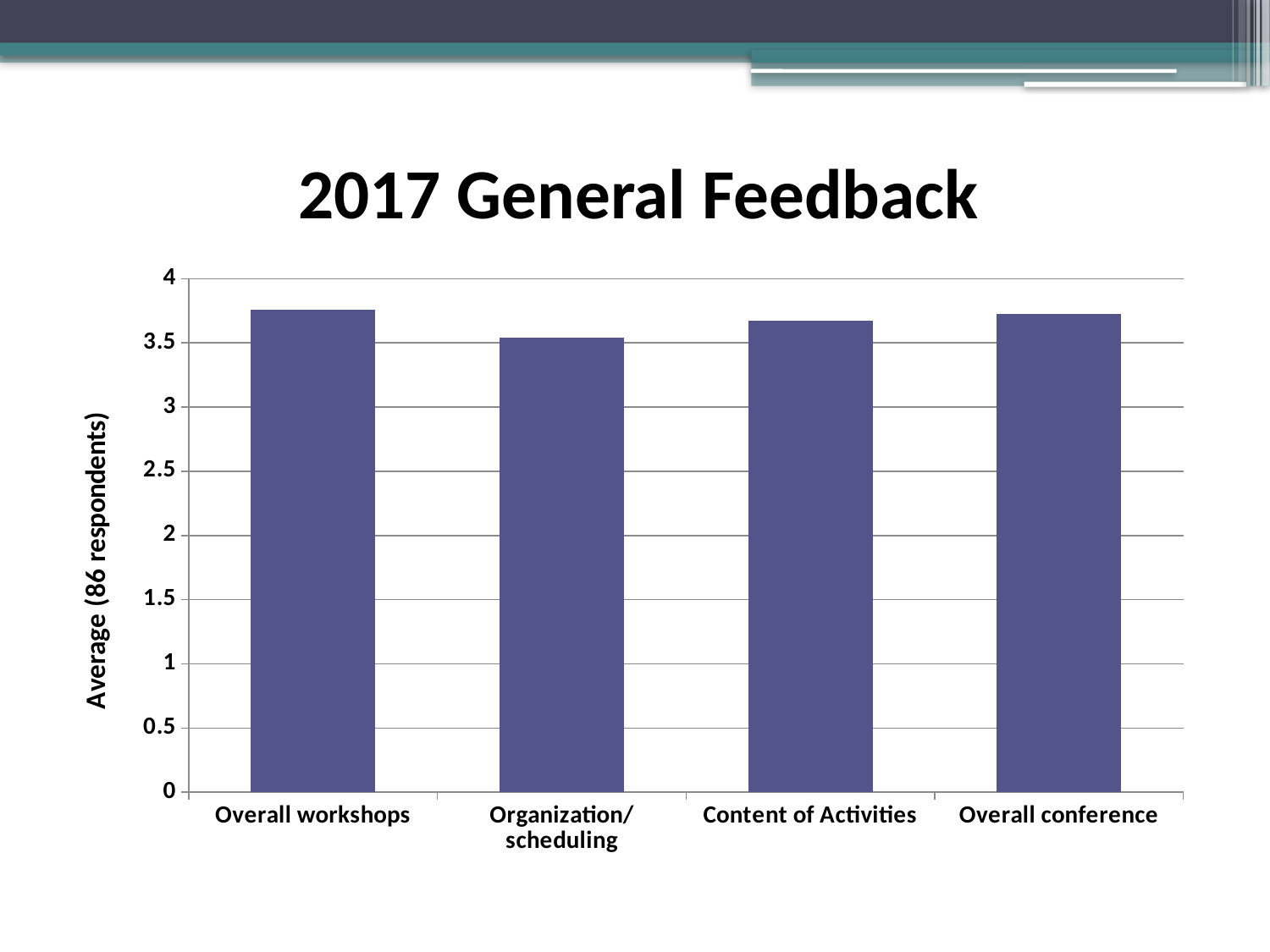
Is the value for Overall workshops greater or less than 3.5? greater Is the value for Organization/scheduling greater or less than 3? greater What kind of chart is shown on the slide? bar chart Which is larger, the value for Overall conference or the value for Organization/scheduling? Overall conference Is the value for Content of Activities greater or less than 3.5? greater What is the label on the vertical axis of the chart? Average (86 respondents) Which is larger, the value for Content of Activities or the value for Organization/scheduling? Content of Activities How many categories are shown on the x axis of the chart? 4 Which is larger, the value for Overall workshops or the value for Organization/scheduling? Overall workshops Which category has the lowest average score? Organization/scheduling What is the title of the chart? 2017 General Feedback